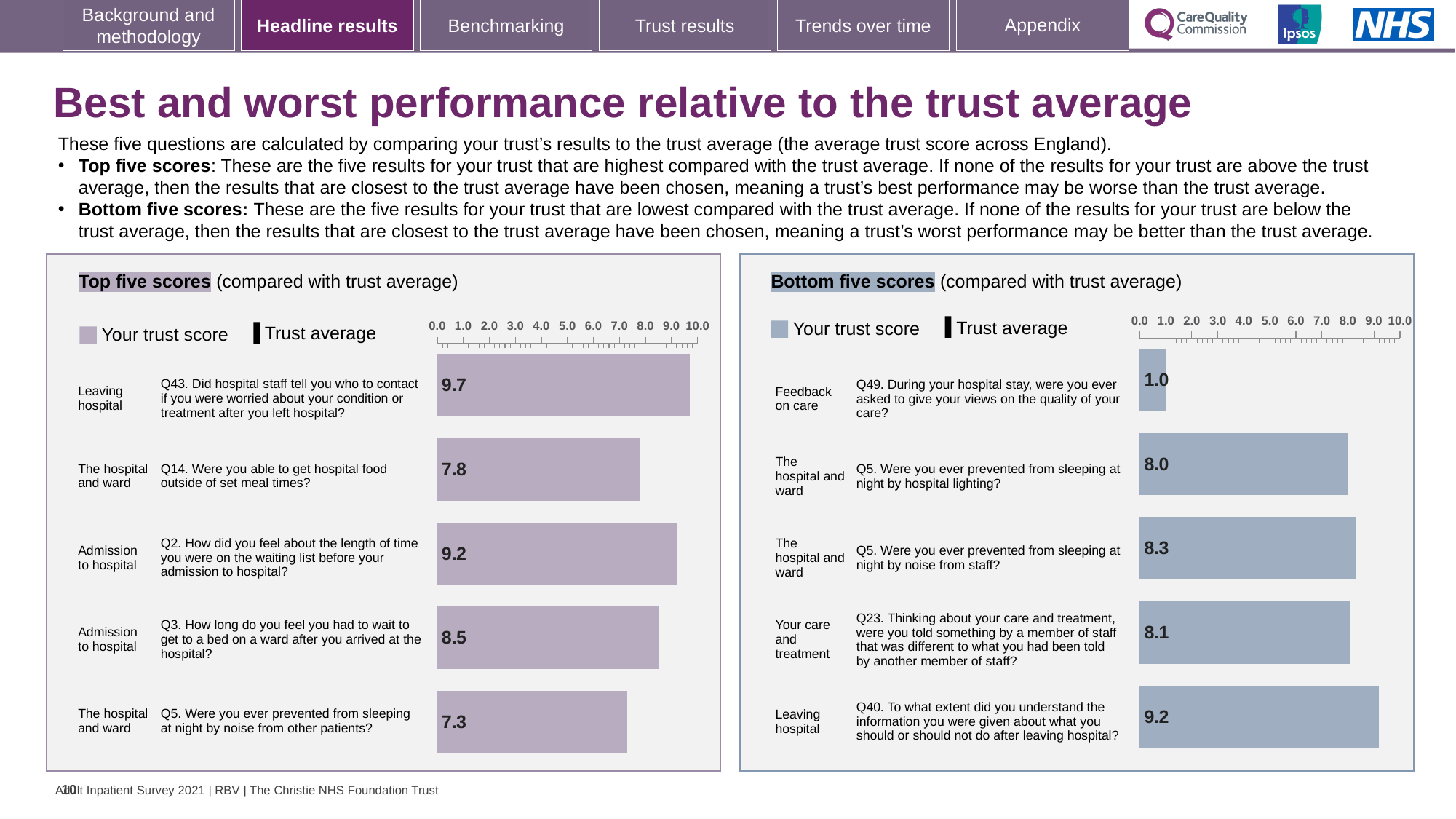
In the Top five scores chart, which question has the lowest trust score? Q5 (noise from other patients) What kind of chart is the Top five scores chart? Bar chart In the Top five scores chart, what is the trust score for Q43 (Did hospital staff tell you who to contact if you were worried about your condition or treatment after you left hospital)? 9.7 In the Bottom five scores chart, what is the trust score for Q49 (During your hospital stay, were you ever asked to give your views on the quality of your care)? 1.0 In the Bottom five scores chart, what is the trust score for Q40 (To what extent did you understand the information you were given about what you should or should not do after leaving hospital)? 9.2 In the Bottom five scores chart, which question has the lowest trust score? Q49 In the Top five scores chart, what is the trust score for Q14 (Were you able to get hospital food outside of set meal times)? 7.8 How many questions are shown in the Bottom five scores chart? 5 In the Top five scores chart, which question has the highest trust score? Q43 In the Bottom five scores chart, which has the larger score: Q5 (lighting) or Q5 (noise from staff)? Q5 (noise from staff) In the Bottom five scores chart, what is the difference between the scores for Q40 and Q49? 8.2 In the Top five scores chart, what is the difference between the scores for Q43 and Q14? 1.9